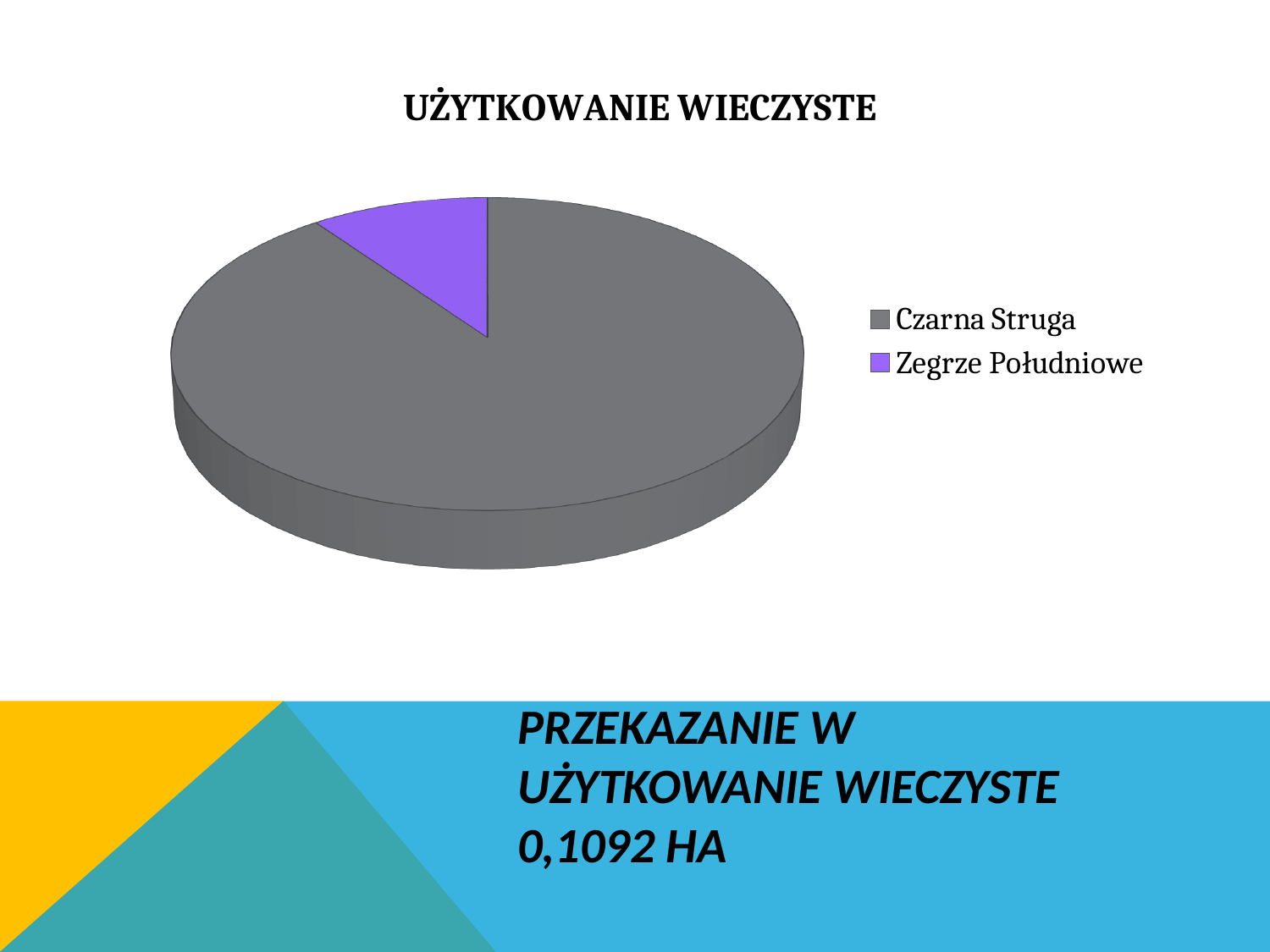
How many series does the legend list? 2 What kind of chart is shown on the slide? pie chart What is the title of the chart? UŻYTKOWANIE WIECZYSTE What colour is the slice for Zegrze Południowe? purple Which category has the smallest slice of the pie? Zegrze Południowe Which slice is larger, Czarna Struga or Zegrze Południowe? Czarna Struga Which category has the largest slice of the pie? Czarna Struga How many slices does the pie chart have? 2